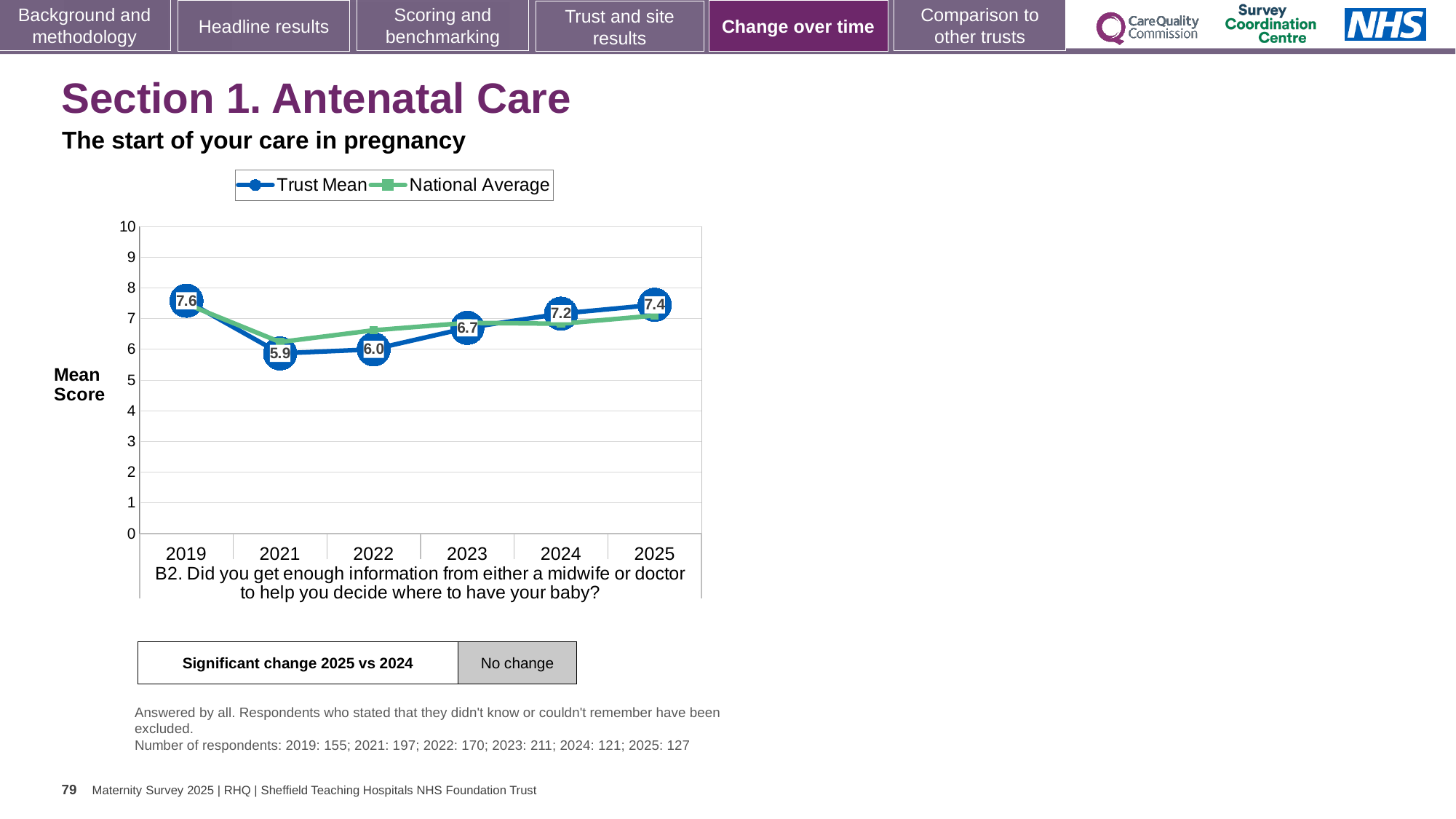
In which year is the Trust Mean lowest? 2021 What is the difference between the Trust Mean in 2019 and in 2021? 1.7 How many series does the legend list? 2 Which is larger, the Trust Mean for 2023 or for 2024? 2024 What is the Trust Mean for 2025? 7.4 What is the Trust Mean for 2019? 7.6 Does the Trust Mean rise or fall from 2021 to 2025? rise Is the National Average for 2021 greater or less than 7? less How many years are shown on the x axis? 6 In which year is the Trust Mean highest? 2019 What is the Trust Mean for 2021? 5.9 What kind of chart is shown? line chart